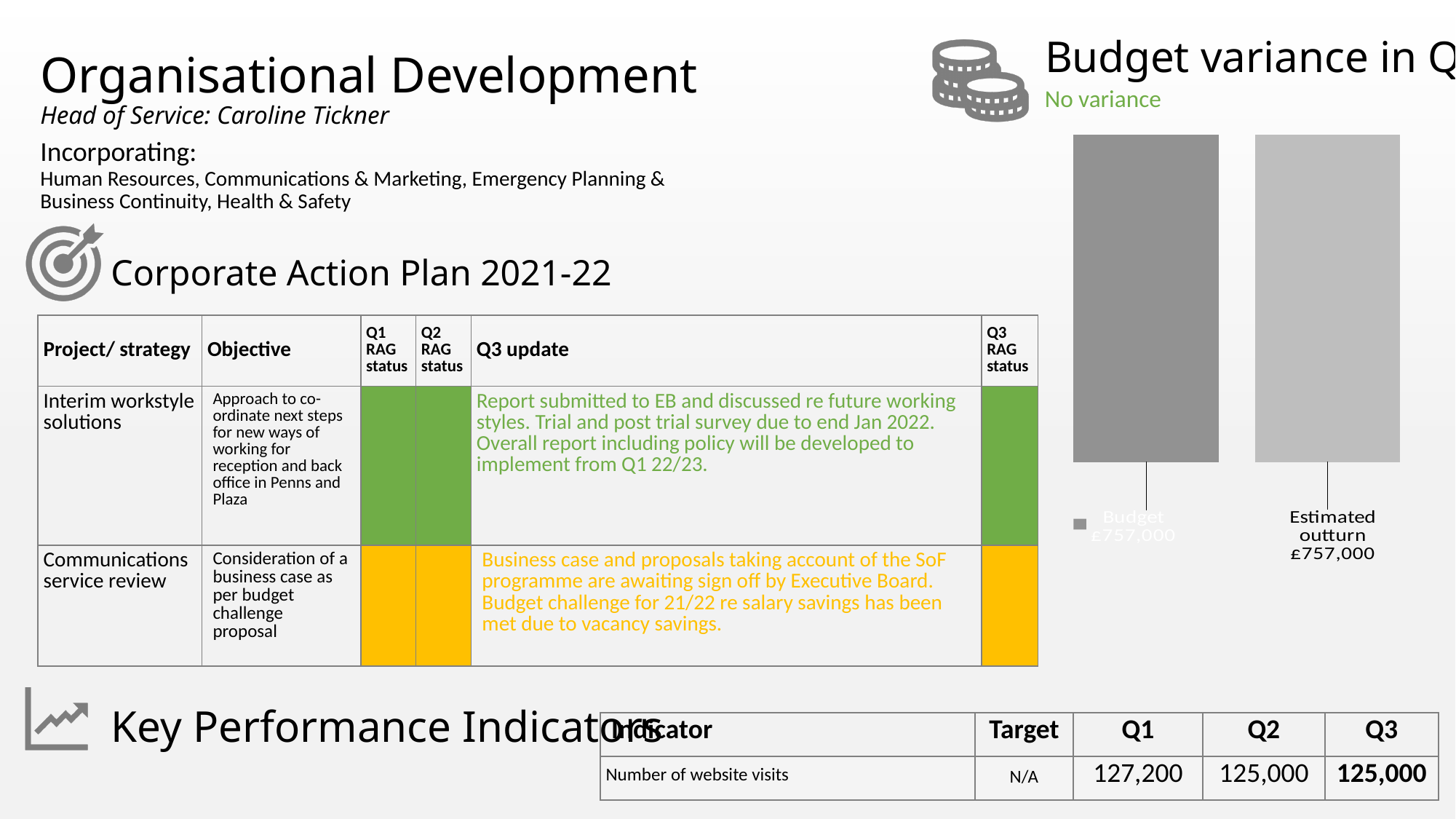
In the Budget variance chart, what is the value of the Estimated outturn bar? £757,000 In the Budget variance chart, what is the difference between the Budget and the Estimated outturn? £0 What text in green appears directly under the Budget variance chart title? No variance In the Budget variance chart, is the Estimated outturn value greater than, less than, or equal to the Budget value? equal How many bars are plotted in the Budget variance chart? 2 In the Budget variance chart, what is the value of the Budget bar? £757,000 What kind of chart is shown under the Budget variance heading? bar chart What are the two category labels on the Budget variance chart? Budget and Estimated outturn